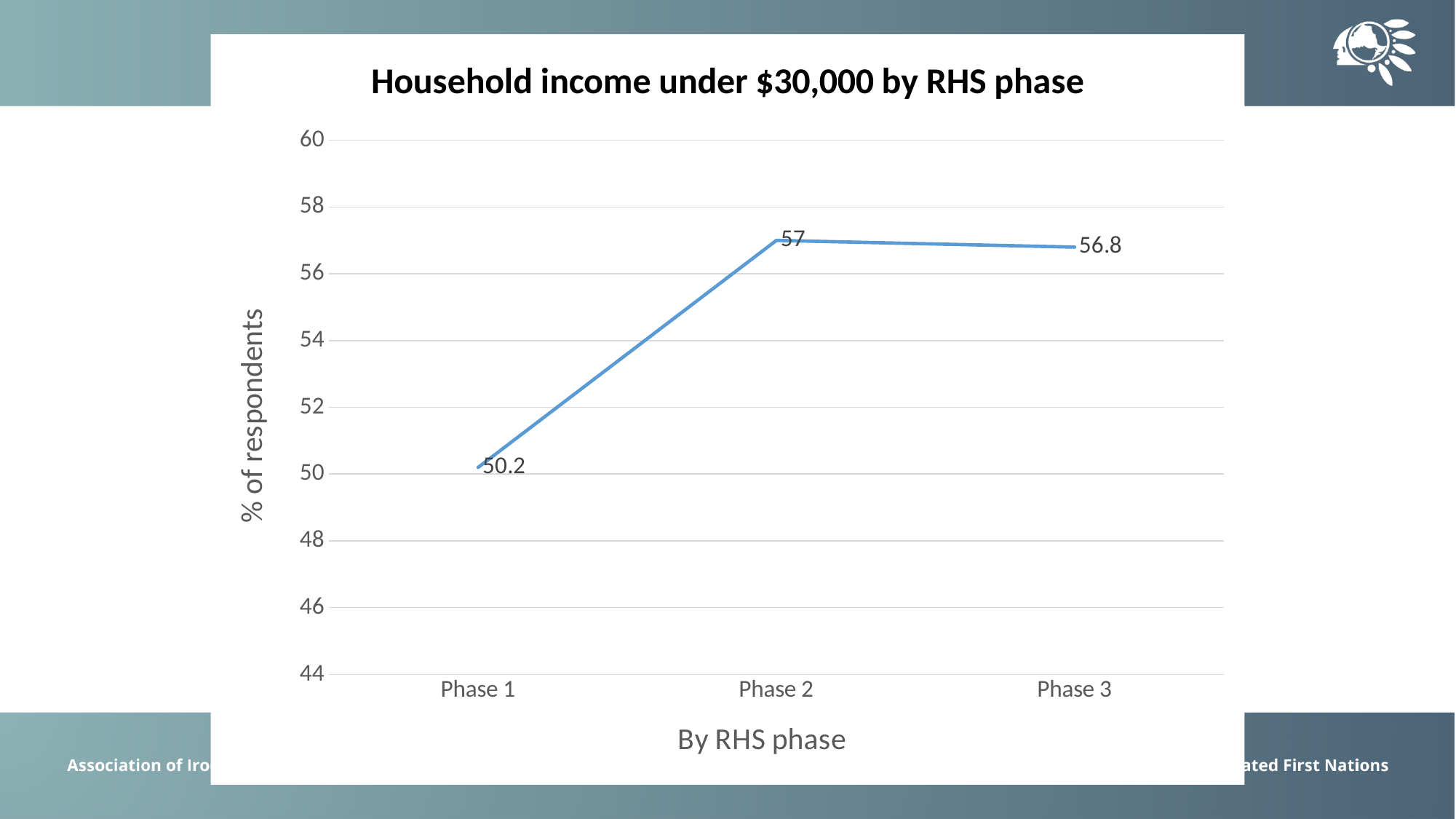
Is the value for Phase 1 greater or less than 52? less Which phase has the lowest value? Phase 1 What is the value for Phase 2? 57 How many phases are plotted on the chart? 3 Which phase has the highest value? Phase 2 Which is larger, the value for Phase 1 or the value for Phase 3? Phase 3 What kind of chart is shown on the slide? line chart What is the difference between the values for Phase 2 and Phase 1? 6.8 What is the value for Phase 3? 56.8 What is the value for Phase 1? 50.2 What is the title of the chart? Household income under $30,000 by RHS phase What is the difference between the values for Phase 2 and Phase 3? 0.2